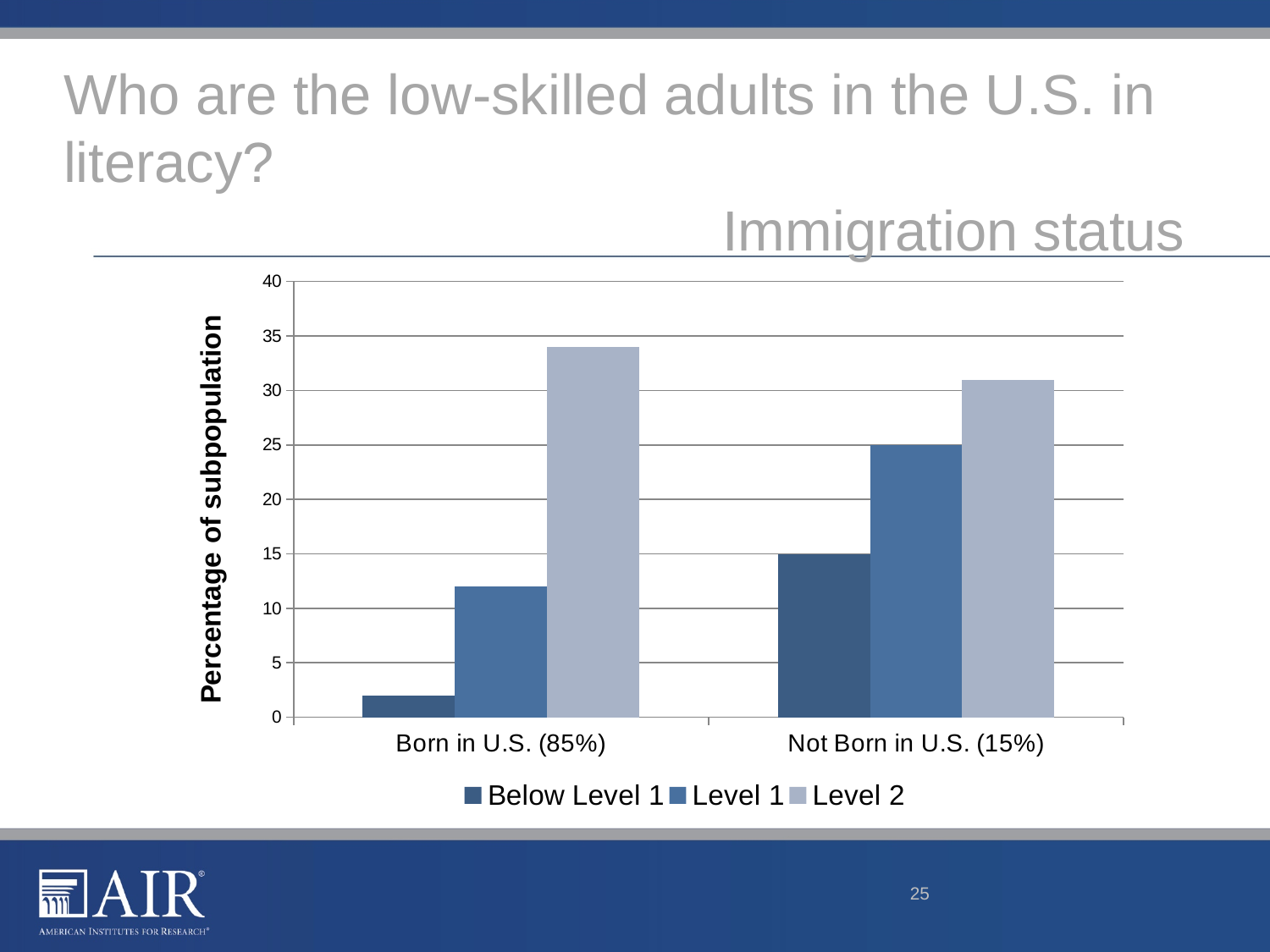
Which series has the highest value for Born in U.S. (85%)? Level 2 What kind of chart is shown on the slide? bar chart Which is larger: the Level 2 value for Born in U.S. (85%) or for Not Born in U.S. (15%)? Born in U.S. (85%) Which is larger: the Below Level 1 value for Born in U.S. (85%) or for Not Born in U.S. (15%)? Not Born in U.S. (15%) Is the Level 2 value for Born in U.S. (85%) greater or less than 30? greater Which series has the lowest value for Not Born in U.S. (15%)? Below Level 1 What is the label of the vertical axis? Percentage of subpopulation Which series has the lowest value for Born in U.S. (85%)? Below Level 1 Is the Below Level 1 value for Born in U.S. (85%) greater or less than 5? less Is the Level 1 value for Born in U.S. (85%) greater or less than 10? greater How many categories are shown on the x axis? 2 How many series does the legend list? 3